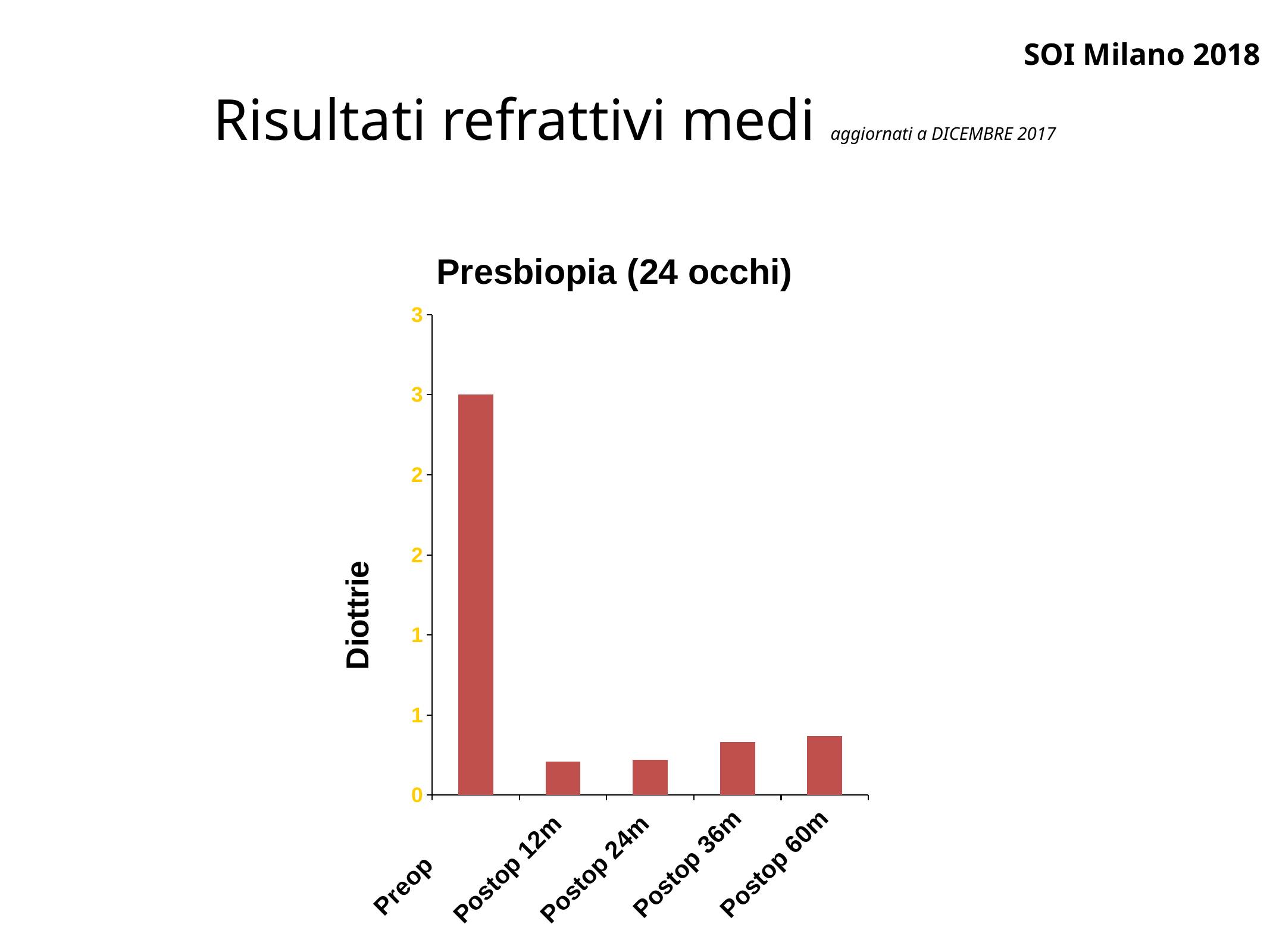
What is the label of the vertical axis? Diottrie What is the title of the chart? Presbiopia (24 occhi) Is the value for Preop greater or less than 2? greater Is the value for Postop 60m greater or less than 1? less How many categories are shown on the x axis? 5 Which is larger, the value for Preop or the value for Postop 60m? Preop What type of chart is shown on the slide? bar chart Which category has the highest value? Preop Do the values rise or fall from Postop 12m to Postop 60m? rise Is the value for Postop 12m greater or less than 1? less Which is larger, the value for Postop 12m or the value for Postop 36m? Postop 36m Which is larger, the value for Postop 24m or the value for Postop 60m? Postop 60m